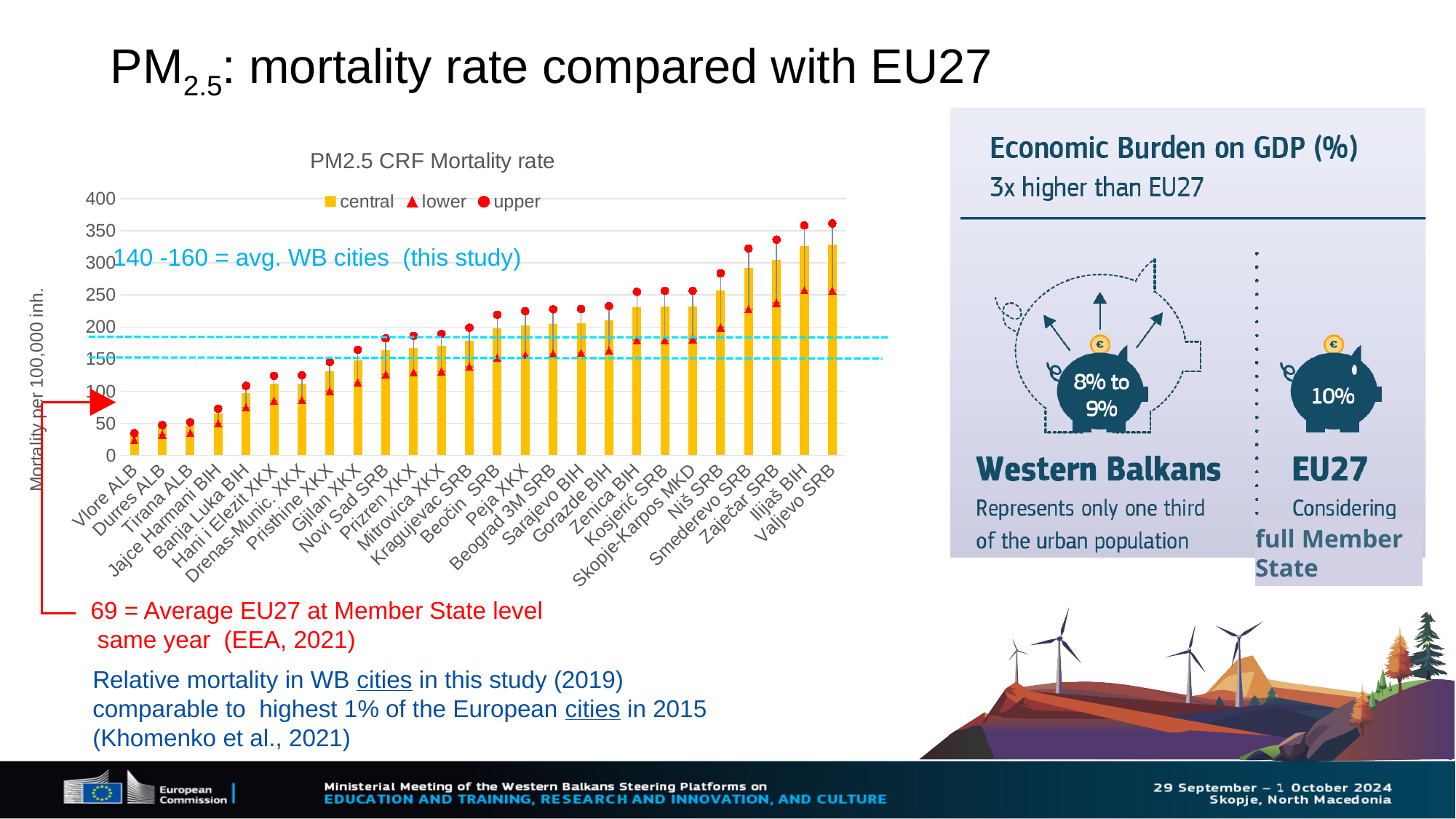
Is the central value for Kragujevac SRB greater or less than 200? less Do the central values in the PM2.5 CRF Mortality rate chart rise or fall from left to right along the x axis? rise Is the central value for Vlore ALB greater or less than 50? less Which series are listed in the legend of the PM2.5 CRF Mortality rate chart? central, lower, upper What kind of chart is the PM2.5 CRF Mortality rate chart? bar chart How many cities are shown on the x axis of the PM2.5 CRF Mortality rate chart? 26 Which city has the lowest central mortality rate in the PM2.5 CRF Mortality rate chart? Vlore ALB How many series does the legend of the PM2.5 CRF Mortality rate chart list? 3 What is the title of the chart on the slide? PM2.5 CRF Mortality rate Is the central value for Zenica BIH greater or less than 200? greater Which has the larger central value, Smederevo SRB or Niš SRB? Smederevo SRB